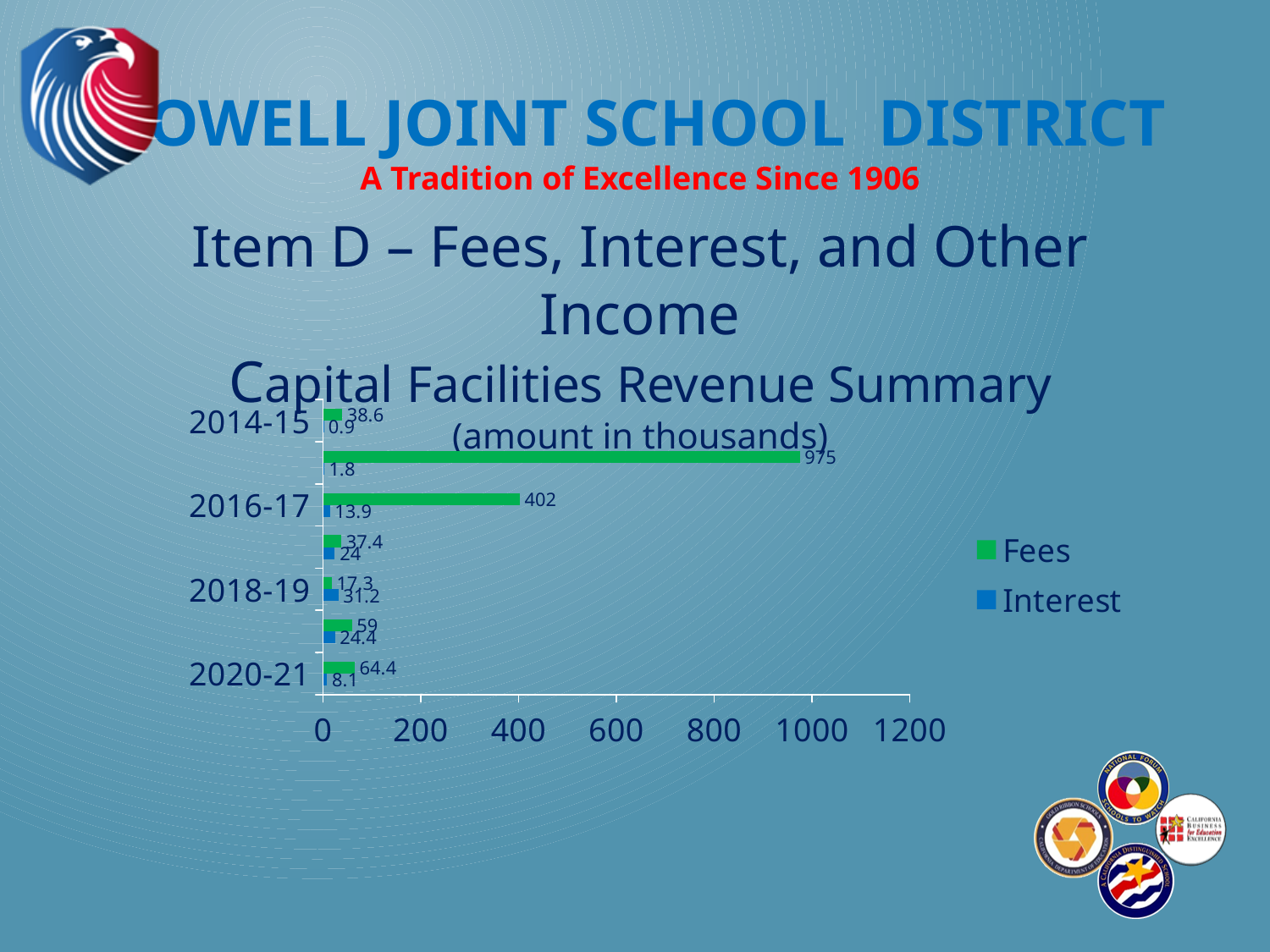
How much larger is the Fees value for 2016-17 than the Fees value for 2020-21? 337.6 How many series does the legend list? 2 What is the Fees value for 2020-21? 64.4 What is the Fees value for 2016-17? 402 What kind of chart is shown on the slide? bar chart Is the Fees value for 2016-17 greater or less than 200? greater For 2018-19, which is larger, Fees or Interest? Interest What is the Interest value for 2020-21? 8.1 What is the highest Fees value shown on the chart? 975 What is the Interest value for 2014-15? 0.9 What is the Interest value for 2018-19? 31.2 What is the difference between Fees and Interest for 2014-15? 37.7